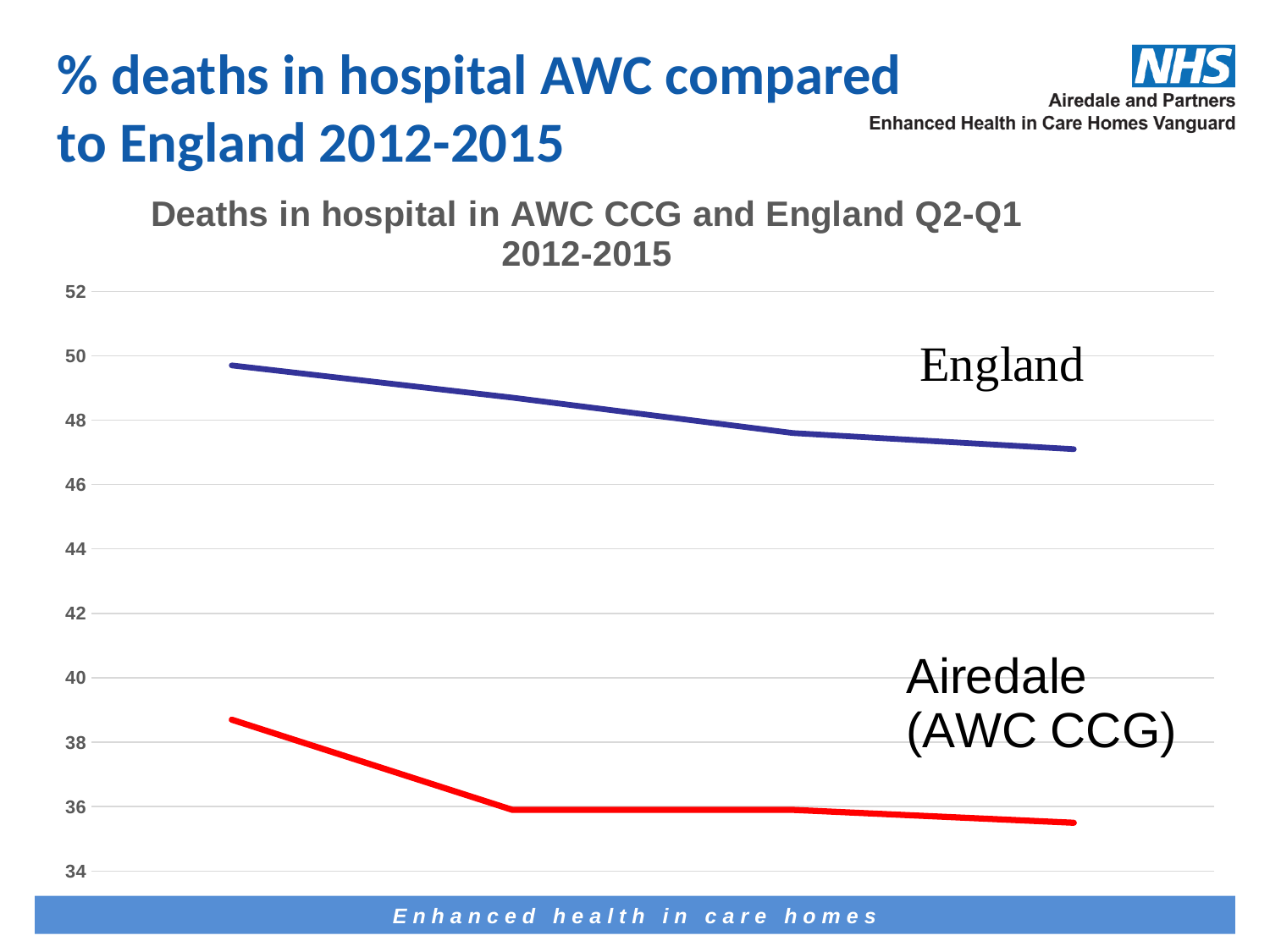
Is the first value of the England line greater or less than 48? greater What kind of chart is shown on the slide? Line chart Does the Airedale (AWC CCG) line rise or fall from left to right? Fall Is the last value of the Airedale (AWC CCG) line greater or less than 36? less Is the first value of the Airedale (AWC CCG) line greater or less than 38? greater How many lines (series) are plotted on the chart? 2 What colour is the Airedale (AWC CCG) line? Red How many data points does the England line have? 4 Does the England line rise or fall from left to right? Fall Which series has the higher values throughout the chart, England or Airedale (AWC CCG)? England What is the title of the chart? Deaths in hospital in AWC CCG and England Q2-Q1 2012-2015